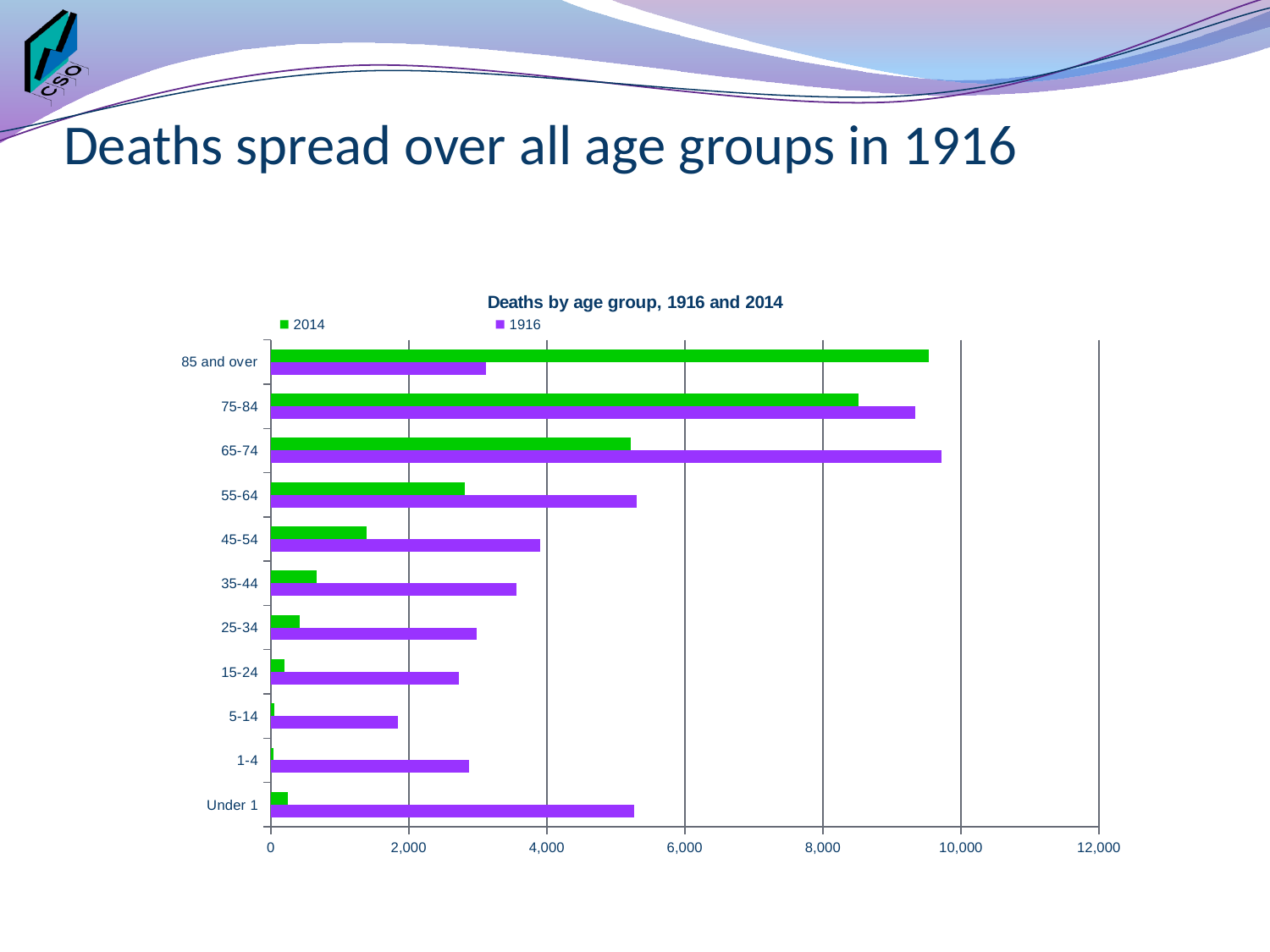
For the 85 and over age group, which series has the larger value, 2014 or 1916? 2014 For the Under 1 age group, which series has the larger value, 2014 or 1916? 1916 Which age group has the highest value for the 2014 series? 85 and over How many series does the legend list? 2 How many age groups are shown on the chart? 11 What is the title of the chart? Deaths by age group, 1916 and 2014 Is the 2014 value for 45-54 greater or less than 2,000? less Is the 2014 value for 85 and over greater or less than 8,000? greater Which age group has the lowest value for the 1916 series? 5-14 What type of chart is shown on the slide? bar chart For the 65-74 age group, which series has the larger value, 2014 or 1916? 1916 Is the 1916 value for Under 1 greater or less than 4,000? greater